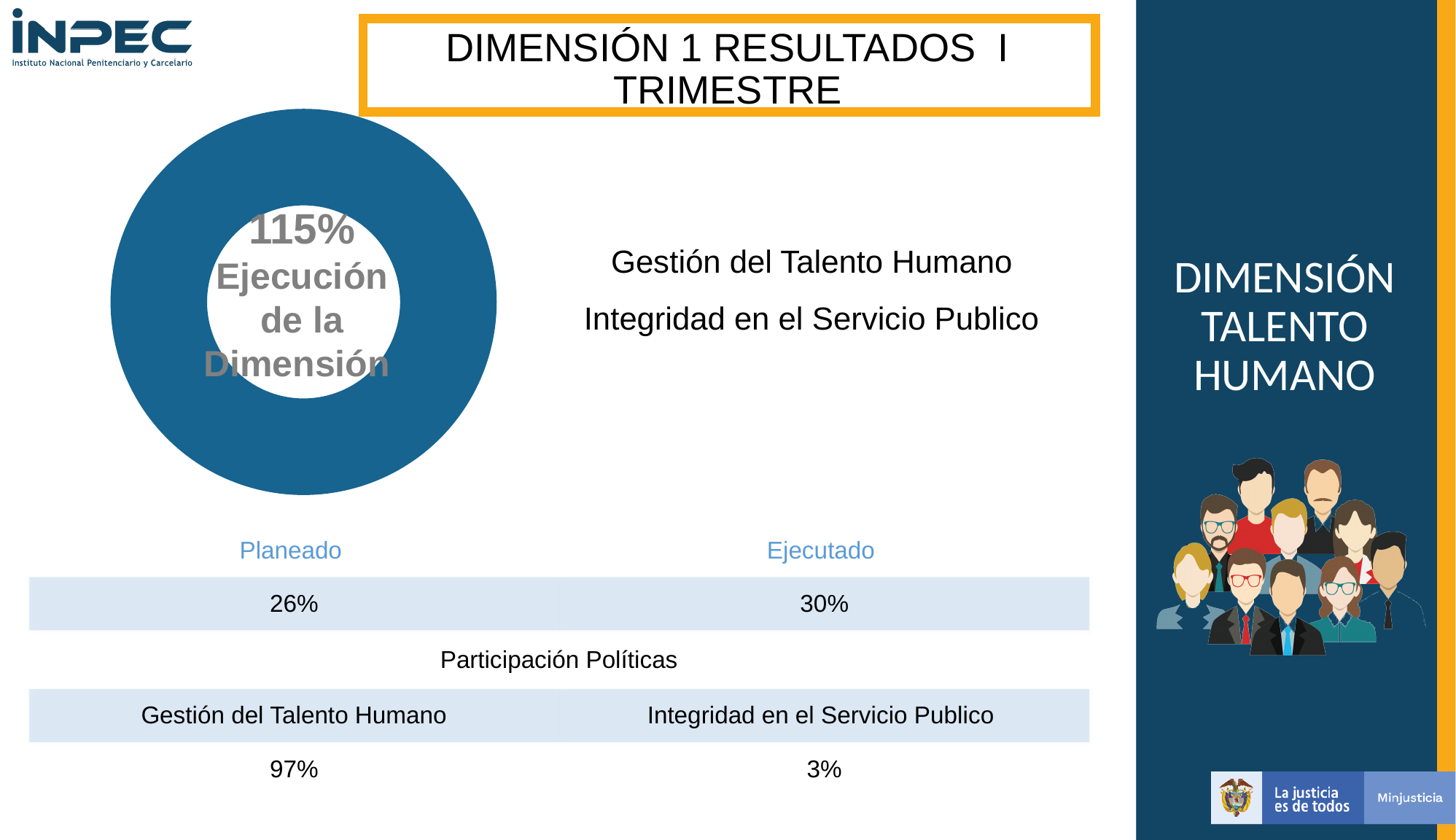
What colour is the ring of the doughnut chart? blue In the table below the doughnut chart, what is the Planeado value? 26% In the table below the doughnut chart, what is the difference between Ejecutado and Planeado? 4% In the table below the doughnut chart, what is the Ejecutado value? 30% How many distinct slices are visible in the doughnut chart? 1 What kind of chart is shown on the left of the slide? doughnut chart What percentage is printed in the centre of the doughnut chart? 115% In the Participación Políticas table, what is the value for Gestión del Talento Humano? 97% Is the value shown in the doughnut chart greater or less than 100%? greater What does the text in the centre of the doughnut chart say the 115% represents? Ejecución de la Dimensión In the Participación Políticas table, what is the value for Integridad en el Servicio Publico? 3% In the table below the doughnut chart, which is larger, Planeado or Ejecutado? Ejecutado